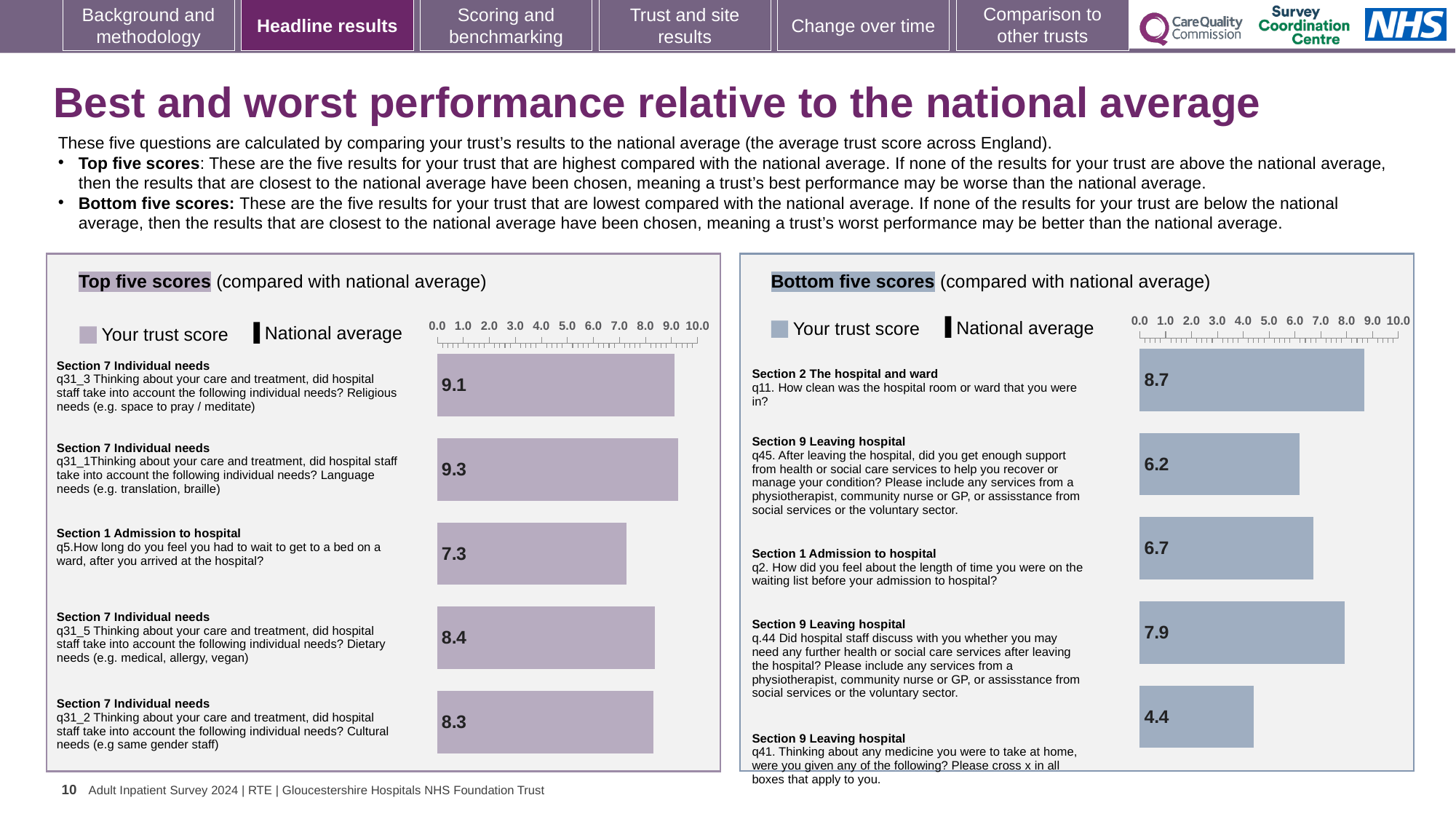
In the Top five scores chart, what is the trust score for q5 (how long you had to wait to get to a bed on a ward)? 7.3 What type of chart is used for the Top five scores? Bar chart In the Bottom five scores chart, what is the trust score for q41 (medicine to take at home)? 4.4 In the Bottom five scores chart, what is the difference between the trust scores for q11 and q45? 2.5 In the Bottom five scores chart, which has the larger trust score: q2 (waiting list) or q44 (discussing further health or social care services)? q44 How many bars are shown in the Bottom five scores chart? 5 How many series does the legend of the Top five scores chart list? 2 In the Top five scores chart, what is the difference between the trust scores for q31_3 (Religious needs) and q31_5 (Dietary needs)? 0.7 In the Top five scores chart, which question has the highest trust score? q31_1 (Language needs) In the Bottom five scores chart, which question has the lowest trust score? q41 (medicine to take at home) In the Top five scores chart, what is the trust score for q31_1 (Language needs)? 9.3 In the Bottom five scores chart, what is the trust score for q11 (how clean was the hospital room or ward)? 8.7